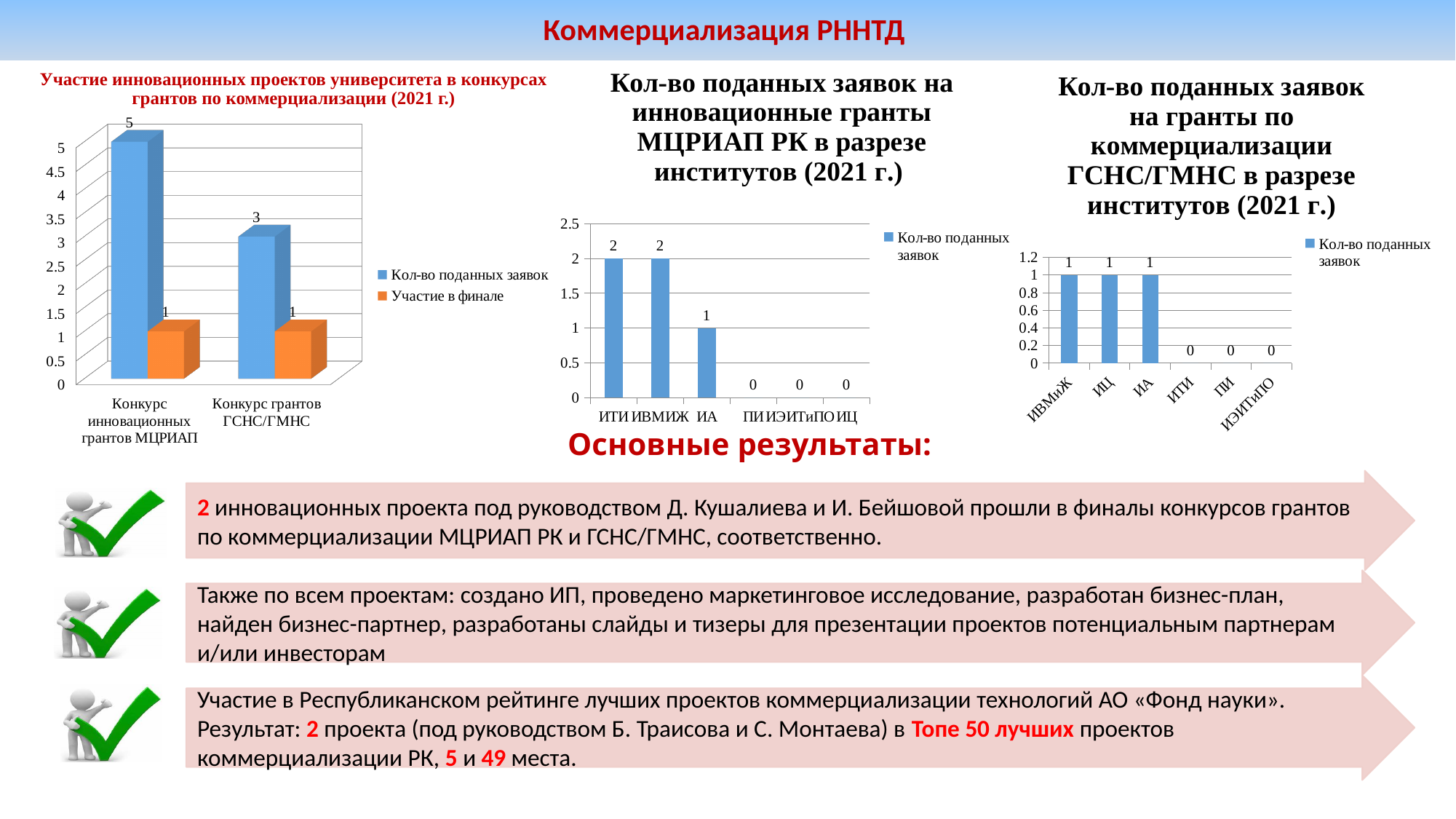
How many series does the legend of the left chart 'Участие инновационных проектов университета в конкурсах грантов по коммерциализации (2021 г.)' list? 2 What kind of chart is the left chart 'Участие инновационных проектов университета в конкурсах грантов по коммерциализации (2021 г.)'? Bar chart In the middle chart 'Кол-во поданных заявок на инновационные гранты МЦРИАП РК в разрезе институтов (2021 г.)', what is the value for ИА? 1 In the left chart 'Участие инновационных проектов университета в конкурсах грантов по коммерциализации (2021 г.)', what is the difference between 'Кол-во поданных заявок' for 'Конкурс инновационных грантов МЦРИАП' and for 'Конкурс грантов ГСНС/ГМНС'? 2 In the right chart 'Кол-во поданных заявок на гранты по коммерциализации ГСНС/ГМНС в разрезе институтов (2021 г.)', what is the value for ИЦ? 1 In the middle chart 'Кол-во поданных заявок на инновационные гранты МЦРИАП РК в разрезе институтов (2021 г.)', what is the value for ПИ? 0 What is the legend entry of the right chart 'Кол-во поданных заявок на гранты по коммерциализации ГСНС/ГМНС в разрезе институтов (2021 г.)'? Кол-во поданных заявок In the left chart 'Участие инновационных проектов университета в конкурсах грантов по коммерциализации (2021 г.)', what is the value of 'Кол-во поданных заявок' for 'Конкурс инновационных грантов МЦРИАП'? 5 In the middle chart 'Кол-во поданных заявок на инновационные гранты МЦРИАП РК в разрезе институтов (2021 г.)', how many categories are shown on the x axis? 6 In the middle chart 'Кол-во поданных заявок на инновационные гранты МЦРИАП РК в разрезе институтов (2021 г.)', which is larger, the value for ИВМиЖ or the value for ИА? ИВМиЖ In the right chart 'Кол-во поданных заявок на гранты по коммерциализации ГСНС/ГМНС в разрезе институтов (2021 г.)', what is the value for ИТИ? 0 In the left chart 'Участие инновационных проектов университета в конкурсах грантов по коммерциализации (2021 г.)', what is the value of 'Участие в финале' for 'Конкурс грантов ГСНС/ГМНС'? 1